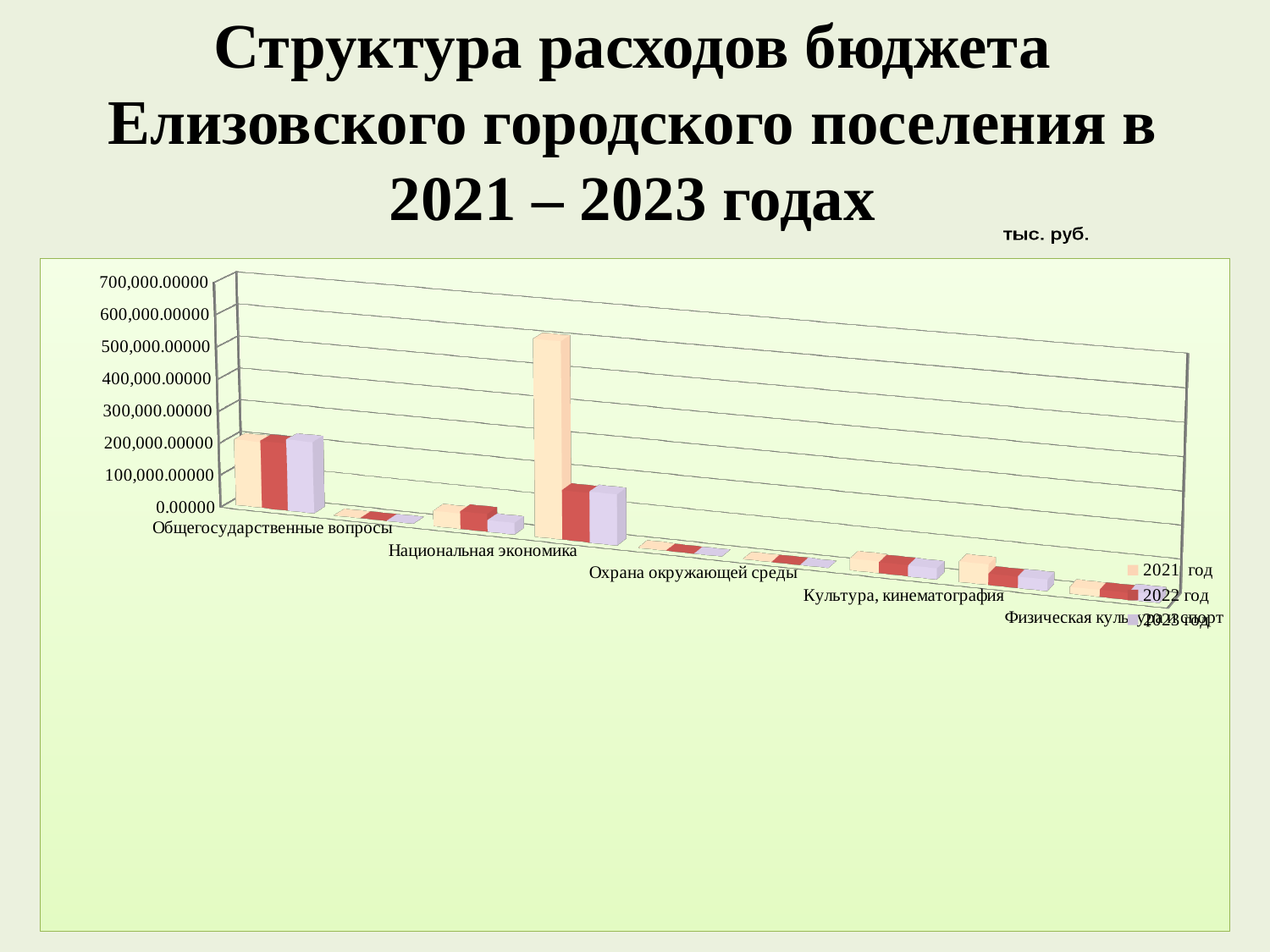
How many series does the legend list? 3 How many category groups of bars are plotted on the chart? 9 Which is larger for 2021 год: Общегосударственные вопросы or Национальная экономика? Общегосударственные вопросы Is the value for Культура, кинематография in 2021 год greater or less than 200,000.00000? less What unit is indicated above the chart? тыс. руб. Is the value for Общегосударственные вопросы in 2021 год greater or less than 100,000.00000? greater What are the series listed in the legend? 2021 год, 2022 год, 2023 год Is the value for Охрана окружающей среды in 2023 год greater or less than 100,000.00000? less Which is larger for 2023 год: Общегосударственные вопросы or Культура, кинематография? Общегосударственные вопросы What kind of chart is shown on the slide? bar chart